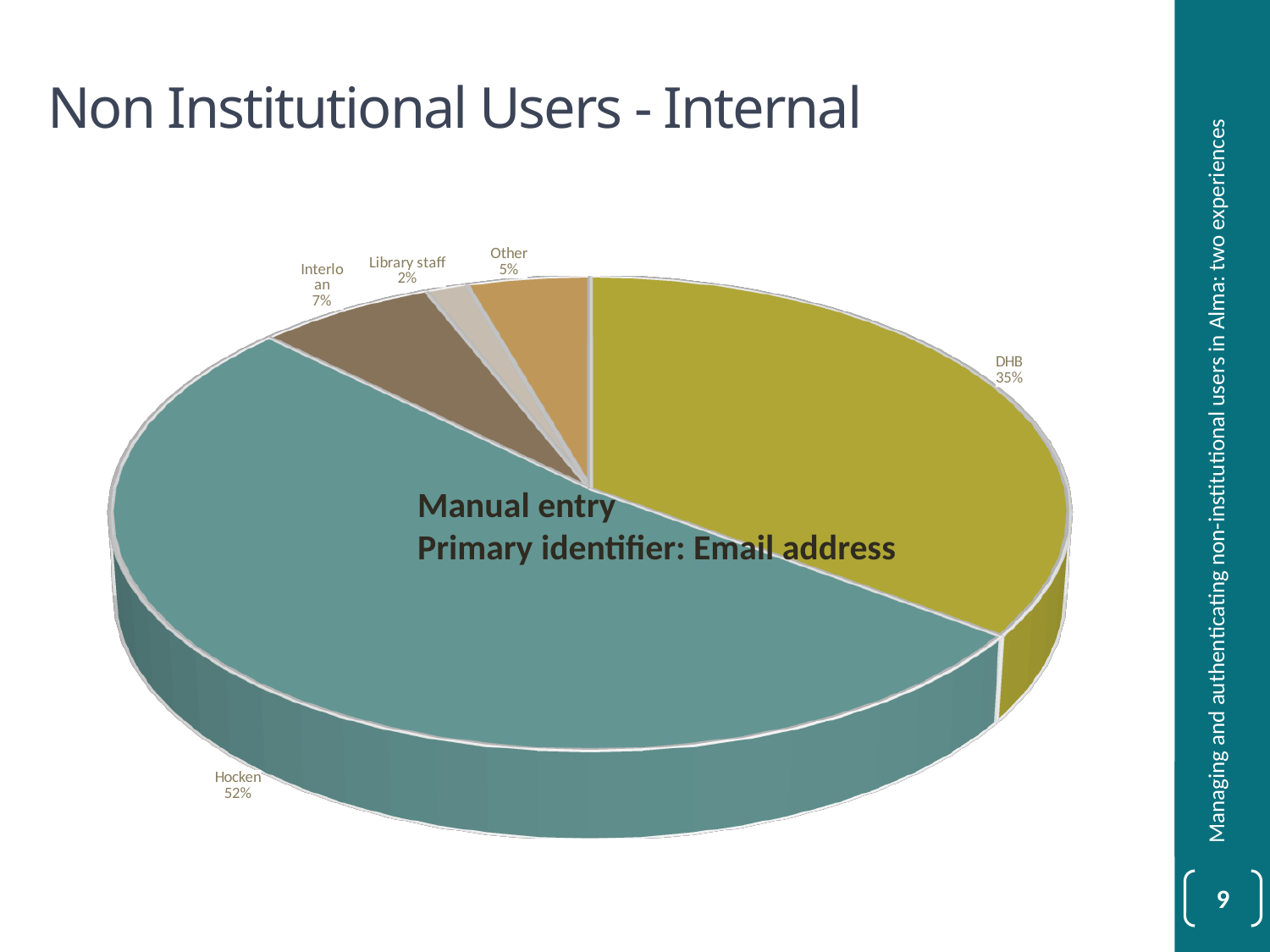
What kind of chart is shown on the slide? pie chart How many slices does the pie chart have? 5 What is the difference in percentage points between Hocken and DHB? 17 What share of the pie does Hocken represent? 52% What percentage is shown for Other? 5% What is the title of the slide containing the pie chart? Non Institutional Users - Internal Which slice of the pie is the smallest? Library staff What share of the pie does DHB represent? 35% Which slice of the pie is the largest? Hocken What percentage is shown for Library staff? 2% Which is larger, the share for Interloan or the share for Other? Interloan What percentage is shown for Interloan? 7%